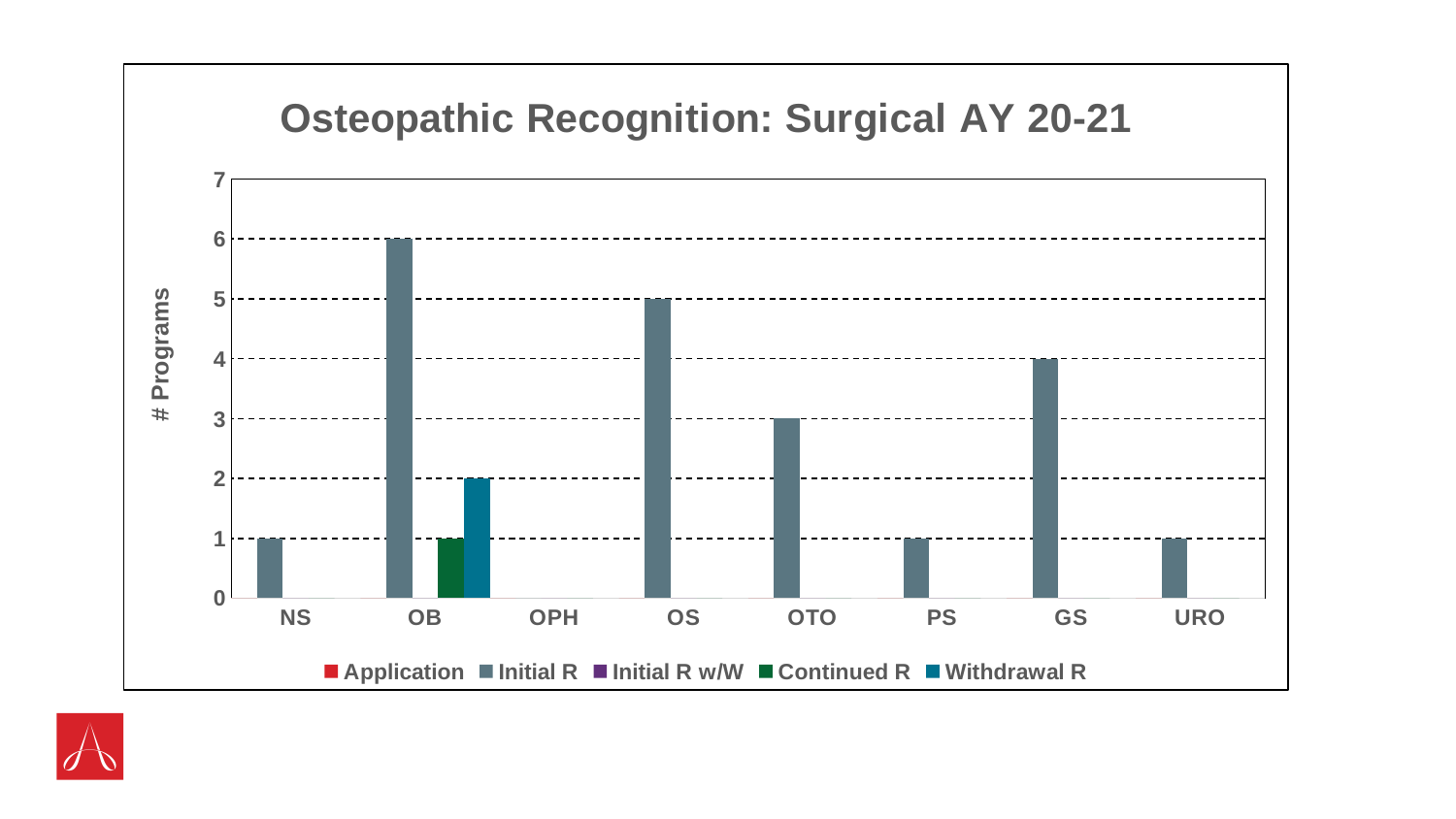
What is the label on the y axis? # Programs How many series does the legend list? 5 What is the Initial R value for OTO? 3 Which is larger, the Initial R value for OTO or for GS? GS Which category has the highest Initial R value? OB How many categories are shown on the x axis? 8 What is the Withdrawal R value for OB? 2 What is the Initial R value for OB? 6 What is the difference between the Initial R values for OB and OS? 1 What type of chart is shown on the slide? bar chart What is the title of the chart? Osteopathic Recognition: Surgical AY 20-21 What is the Continued R value for OB? 1